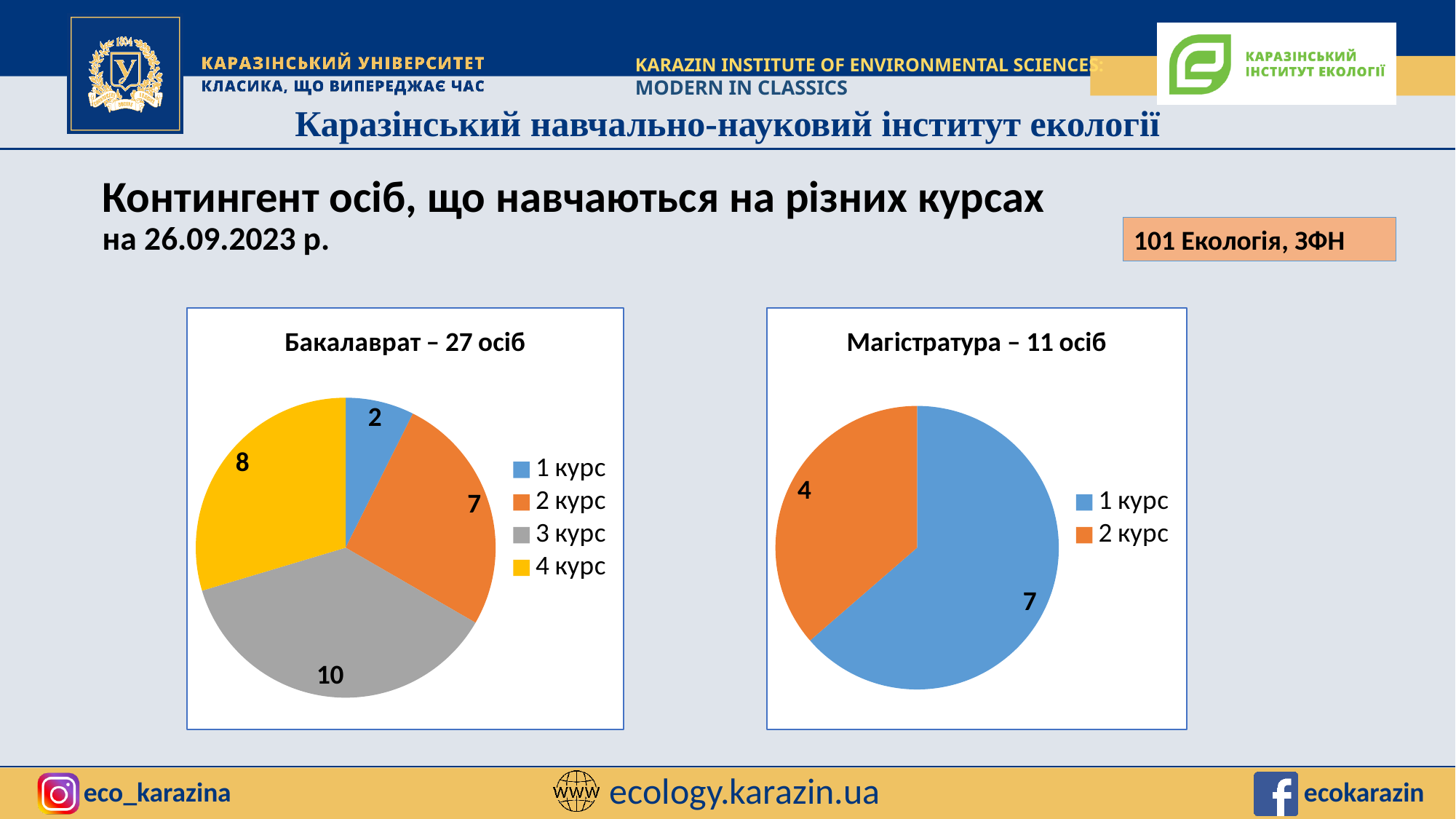
In the chart titled "Магістратура – 11 осіб", which category has the larger slice? 1 курс In the chart titled "Бакалаврат – 27 осіб", which category has the smallest slice? 1 курс In the chart titled "Магістратура – 11 осіб", what is the value for 2 курс? 4 In the chart titled "Бакалаврат – 27 осіб", what is the difference between the values for 3 курс and 1 курс? 8 In the chart titled "Бакалаврат – 27 осіб", which category has the largest slice? 3 курс What kind of chart is the chart titled "Магістратура – 11 осіб"? Pie chart In the chart titled "Бакалаврат – 27 осіб", is the value for 4 курс larger than the value for 2 курс? Yes In the chart titled "Бакалаврат – 27 осіб", what is the value for 1 курс? 2 In the chart titled "Магістратура – 11 осіб", what is the difference between the values for 1 курс and 2 курс? 3 In the chart titled "Бакалаврат – 27 осіб", what is the value for 3 курс? 10 How many entries does the legend of the chart titled "Магістратура – 11 осіб" list? 2 How many categories does the chart titled "Бакалаврат – 27 осіб" show? 4